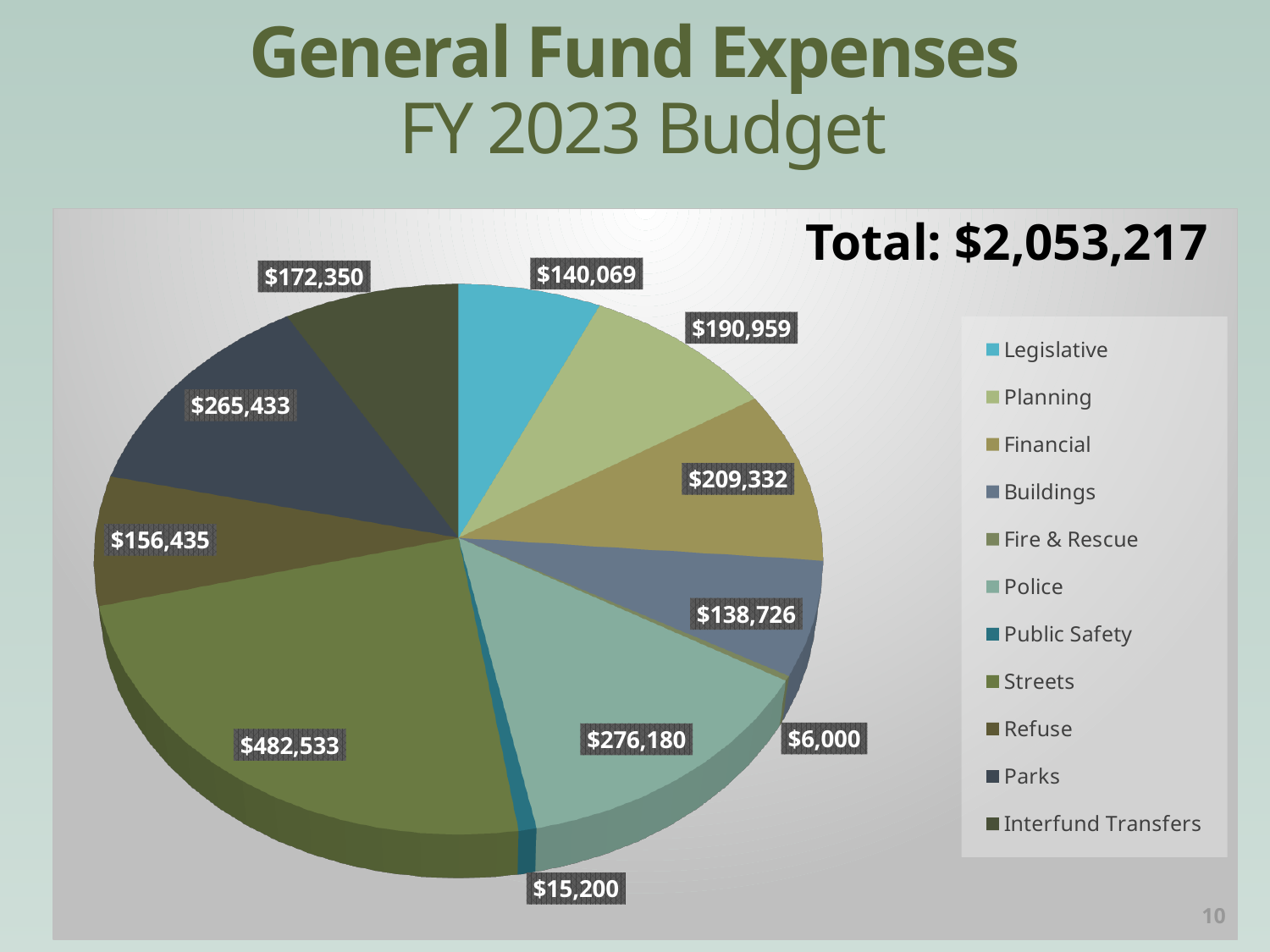
What is the difference between the Streets expense and the Police expense? $206,353 How many categories does the legend list? 11 What is the budgeted expense for Streets? $482,533 What is the budgeted expense for Parks? $265,433 Which is larger, the Planning expense or the Financial expense? Financial What kind of chart is shown on the slide? Pie chart What is the title of the slide containing the chart? General Fund Expenses FY 2023 Budget What is the budgeted expense for Fire & Rescue? $6,000 What is the budgeted expense for Police? $276,180 What total is shown on the slide for General Fund Expenses? $2,053,217 Which category has the smallest expense? Fire & Rescue Which category has the largest expense? Streets